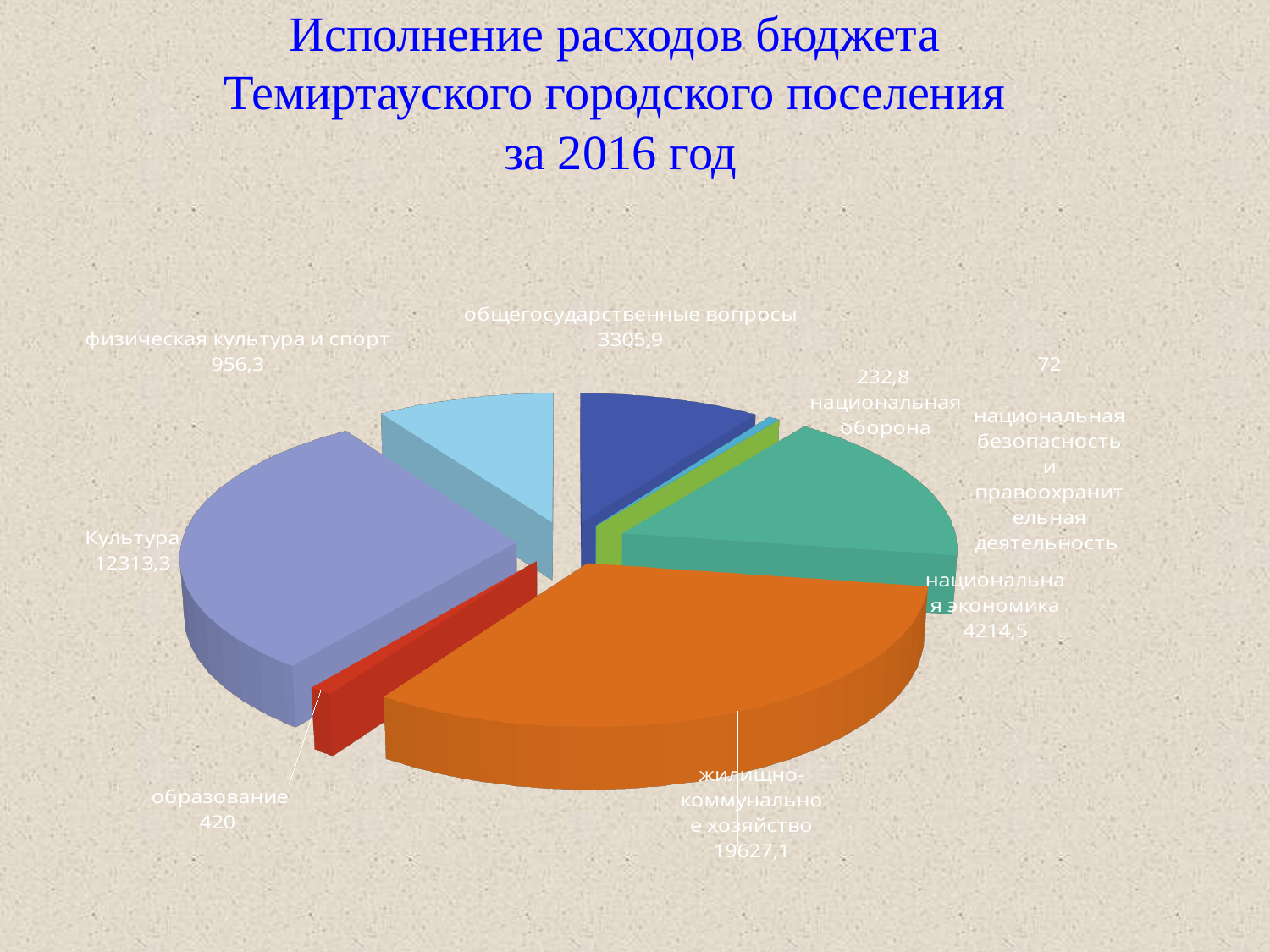
Which category has the largest slice of the pie? жилищно-коммунальное хозяйство What kind of chart is shown on the slide? pie chart Which is larger, the value for национальная экономика or the value for общегосударственные вопросы? национальная экономика How many categories are shown in the pie chart? 8 What is the value for национальная оборона? 232,8 What is the value for жилищно-коммунальное хозяйство? 19627,1 What is the value for общегосударственные вопросы? 3305,9 What is the difference between the values for образование and национальная безопасность и правоохранительная деятельность? 348 Which category has the smallest value? национальная безопасность и правоохранительная деятельность What is the difference between the values for Культура and физическая культура и спорт? 11357 What is the value for национальная экономика? 4214,5 What is the value for Культура? 12313,3